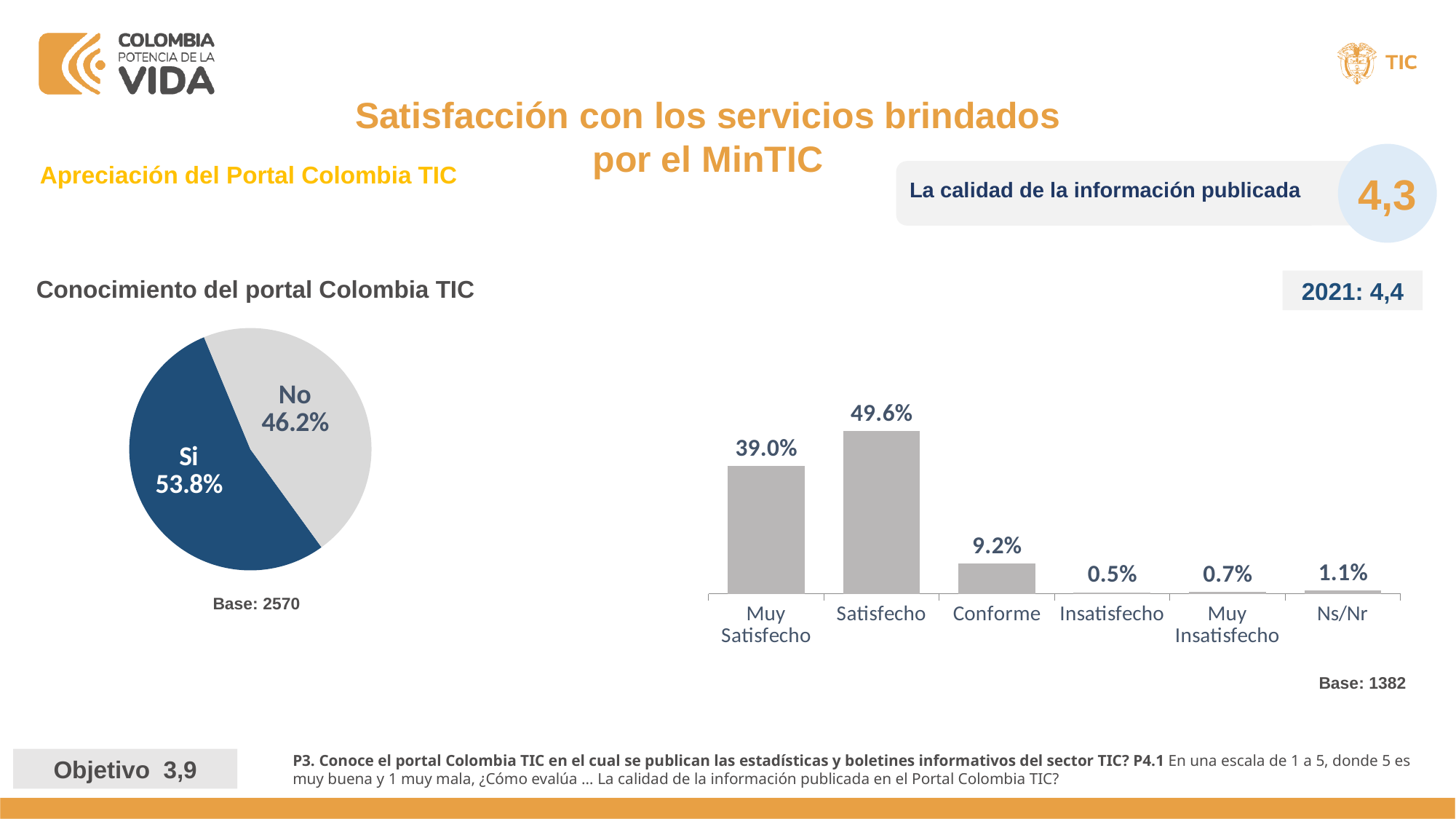
In the pie chart 'Conocimiento del portal Colombia TIC', which slice is larger, 'Si' or 'No'? Si In the bar chart on the right, what is the difference between 'Satisfecho' and 'Muy Satisfecho'? 10.6% What kind of chart is the chart on the left of the slide? Pie chart In the bar chart on the right, which category has the lowest value? Insatisfecho In the bar chart on the right, what is the value for 'Satisfecho'? 49.6% In the pie chart 'Conocimiento del portal Colombia TIC', what share of respondents answered 'Si'? 53.8% In the pie chart 'Conocimiento del portal Colombia TIC', what share of respondents answered 'No'? 46.2% In the bar chart on the right, what is the value for 'Muy Satisfecho'? 39.0% In the bar chart on the right, what is the value for 'Conforme'? 9.2% In the bar chart on the right, which category has the highest value? Satisfecho In the pie chart 'Conocimiento del portal Colombia TIC', how many slices are there? 2 In the bar chart on the right, how many categories are shown on the x axis? 6